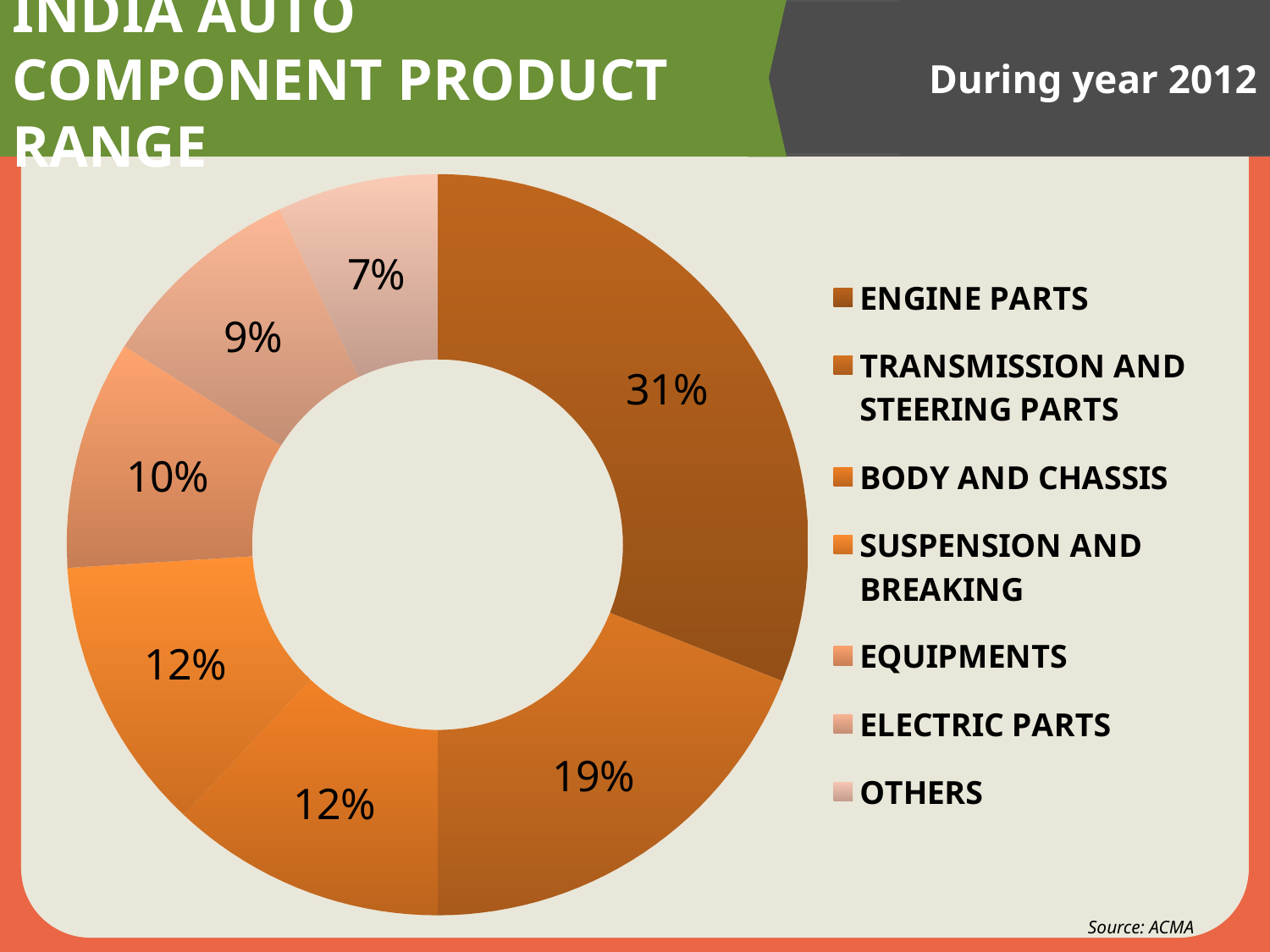
Which category has the smallest share of the chart? Others What type of chart is shown on the slide? Doughnut chart How many categories are shown in the chart? 7 Which category has the largest share of the chart? Engine Parts What percentage share does Transmission and Steering Parts have? 19% What percentage share does Equipments have? 10% Which has a larger share, Equipments or Electric Parts? Equipments What percentage share does Engine Parts have in the chart? 31% What is the difference in percentage points between Engine Parts and Transmission and Steering Parts? 12 What percentage share does Electric Parts have? 9% What percentage share does Others have? 7% What source is cited for the chart data? ACMA